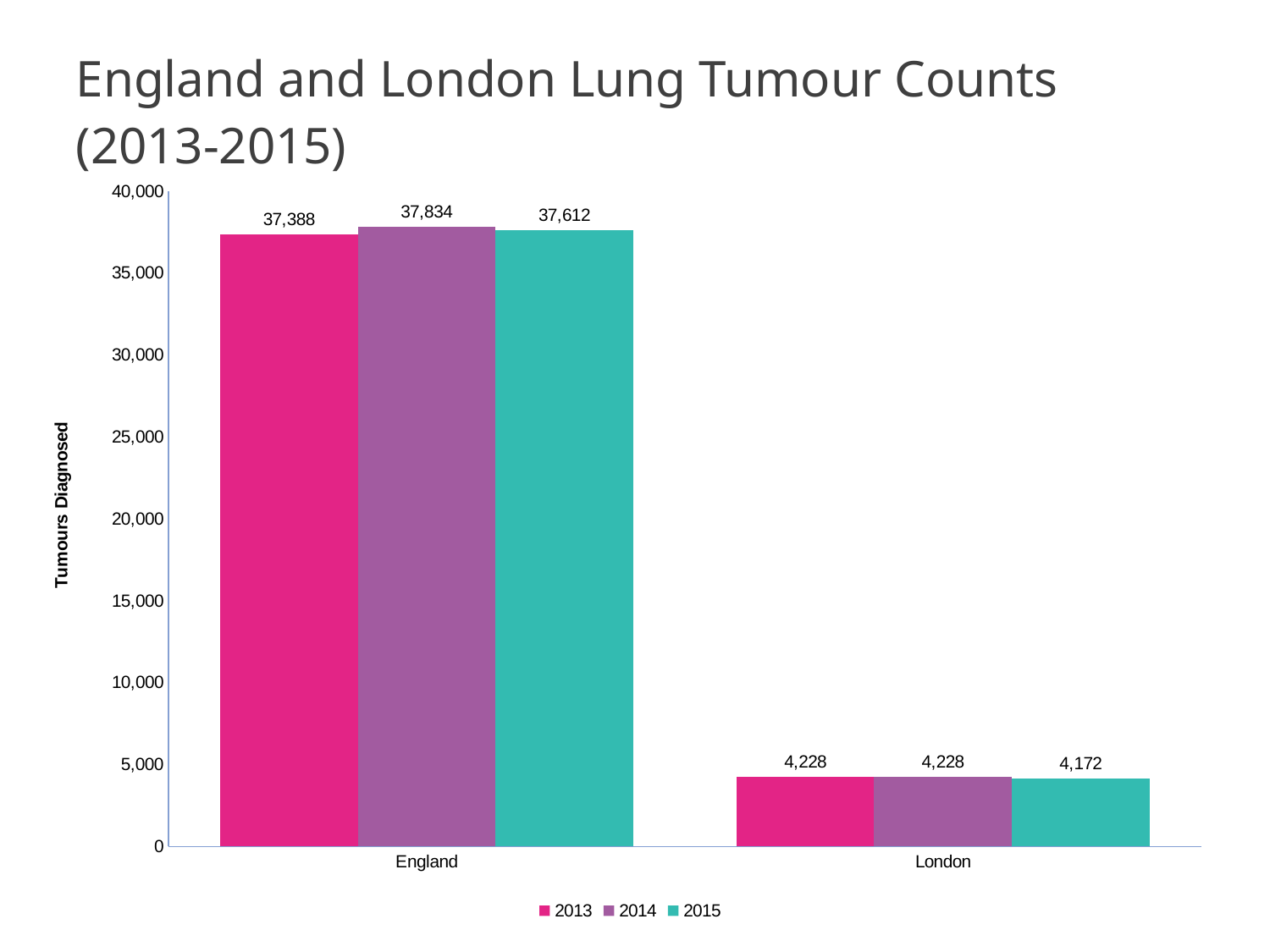
What was the lung tumour count for London in 2015? 4,172 Is the value for London in 2014 greater or less than 5,000? less What was the lung tumour count for England in 2013? 37,388 What is the difference between the England counts in 2014 and 2013? 446 Which year had the lowest lung tumour count for London? 2015 How many series does the legend list? 3 What kind of chart is shown on the slide? Bar chart Which is larger, the England count in 2015 or the England count in 2013? England count in 2015 What is the difference between the London counts in 2013 and 2015? 56 What was the lung tumour count for England in 2014? 37,834 What is the label of the vertical axis? Tumours Diagnosed Which year had the highest lung tumour count for England? 2014